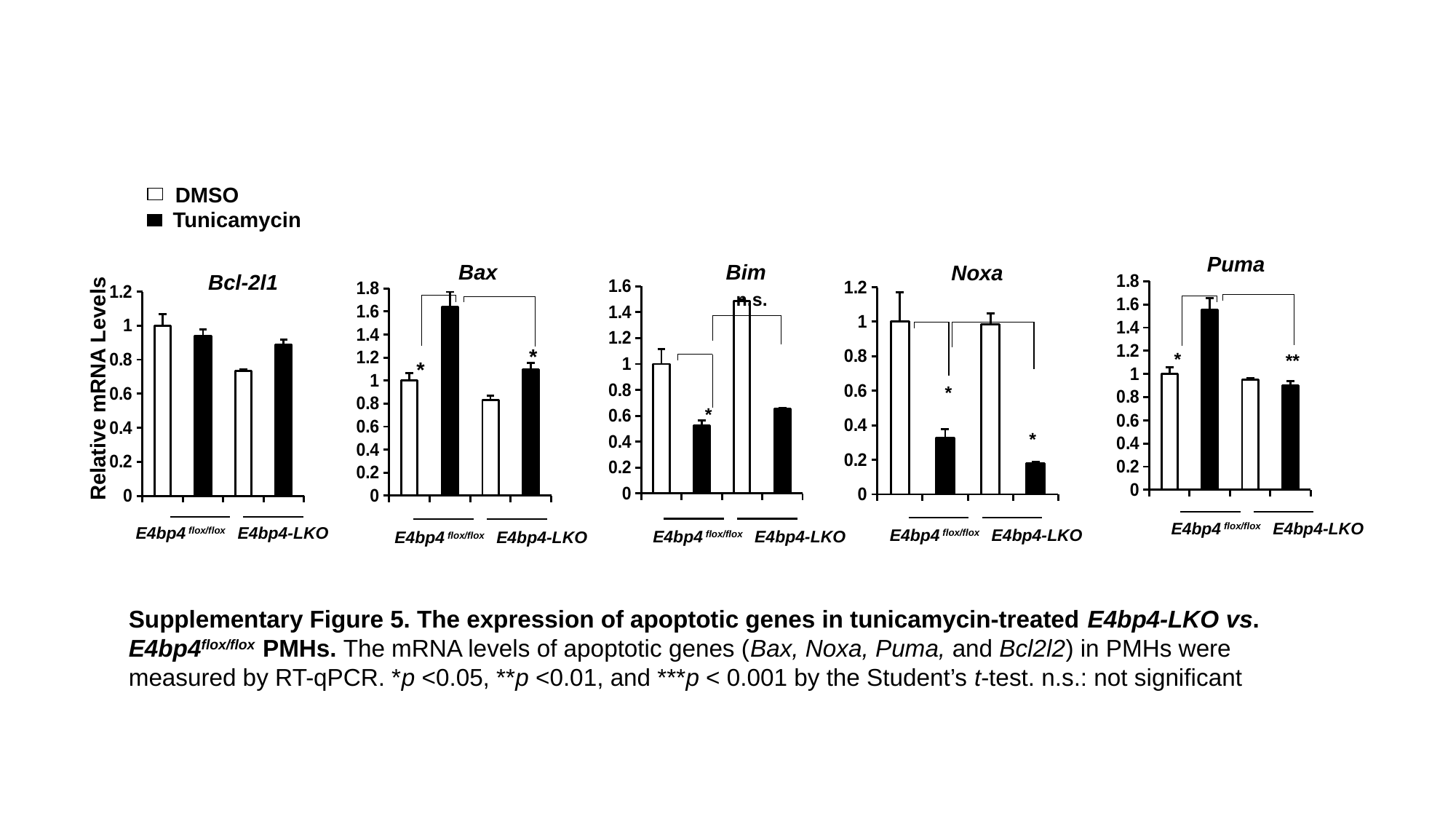
In the Bim chart, which is larger for E4bp4-LKO: the DMSO bar or the Tunicamycin bar? DMSO How many series does the legend list? 2 In the Noxa chart, which bar is the lowest? Tunicamycin in E4bp4-LKO In the Bax chart, is the Tunicamycin value for E4bp4 flox/flox greater or less than 1.4? greater How many separate gene charts are shown on the slide? 5 In the Bim chart, is the Tunicamycin value for E4bp4 flox/flox greater or less than 0.8? less In the Puma chart, is the Tunicamycin value for E4bp4 flox/flox greater or less than 1.2? greater In the Bax chart, which bar is the highest? Tunicamycin in E4bp4 flox/flox What are the two series named in the legend? DMSO and Tunicamycin What kind of chart is used for the Bax panel? bar chart